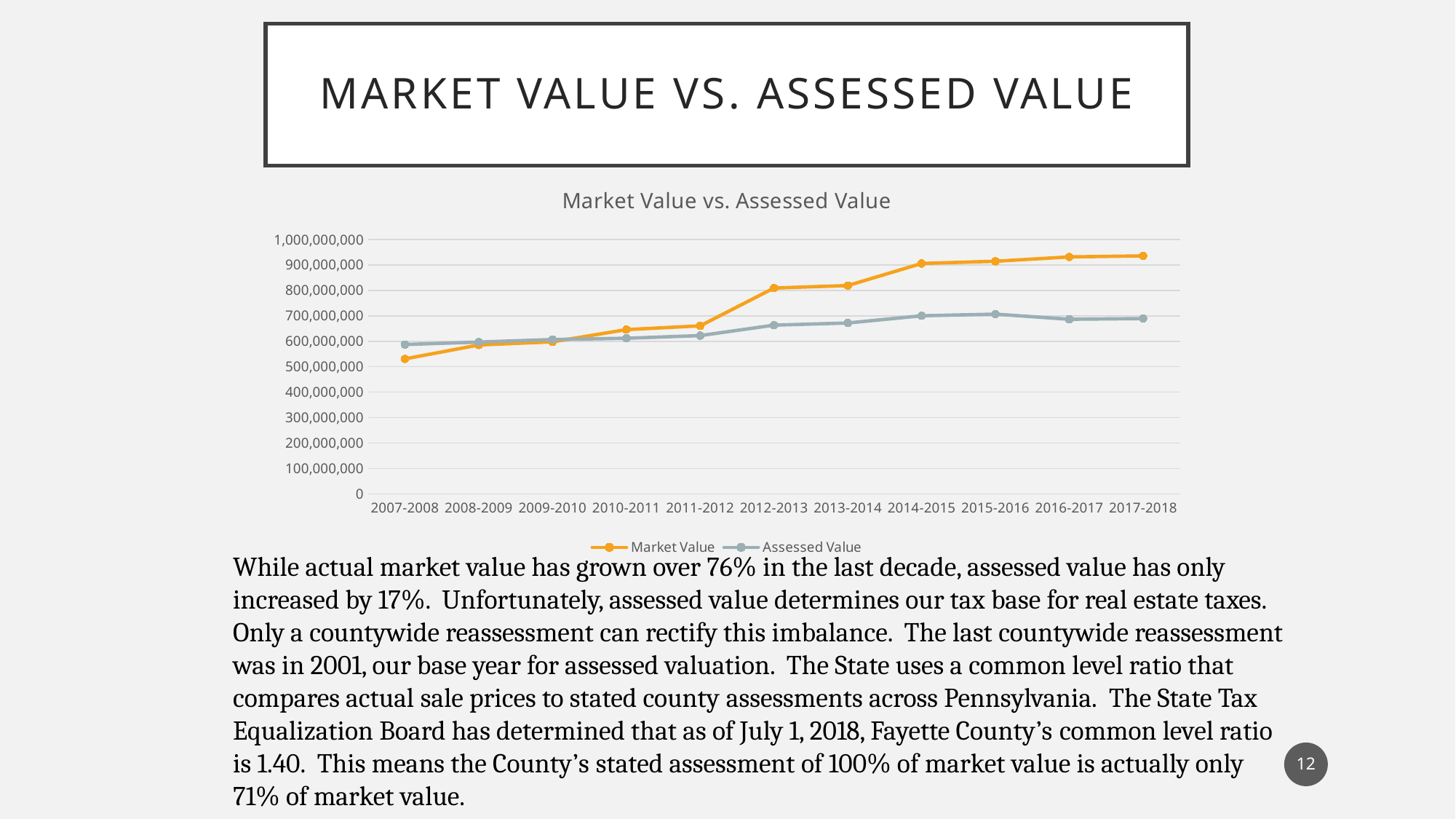
How many series does the chart legend list? 2 Does the Market Value series generally rise or fall from 2007-2008 to 2017-2018? rise In 2007-2008, which is larger, Market Value or Assessed Value? Assessed Value Is the Market Value for 2017-2018 greater or less than 900,000,000? greater In which period is the Market Value lowest? 2007-2008 In 2017-2018, which is larger, Market Value or Assessed Value? Market Value Which series is drawn in orange? Market Value How many fiscal-year periods are plotted along the x axis? 11 What kind of chart is shown on the slide? line chart Is the Market Value for 2007-2008 greater or less than 600,000,000? less Is the Market Value for 2011-2012 greater or less than 700,000,000? less